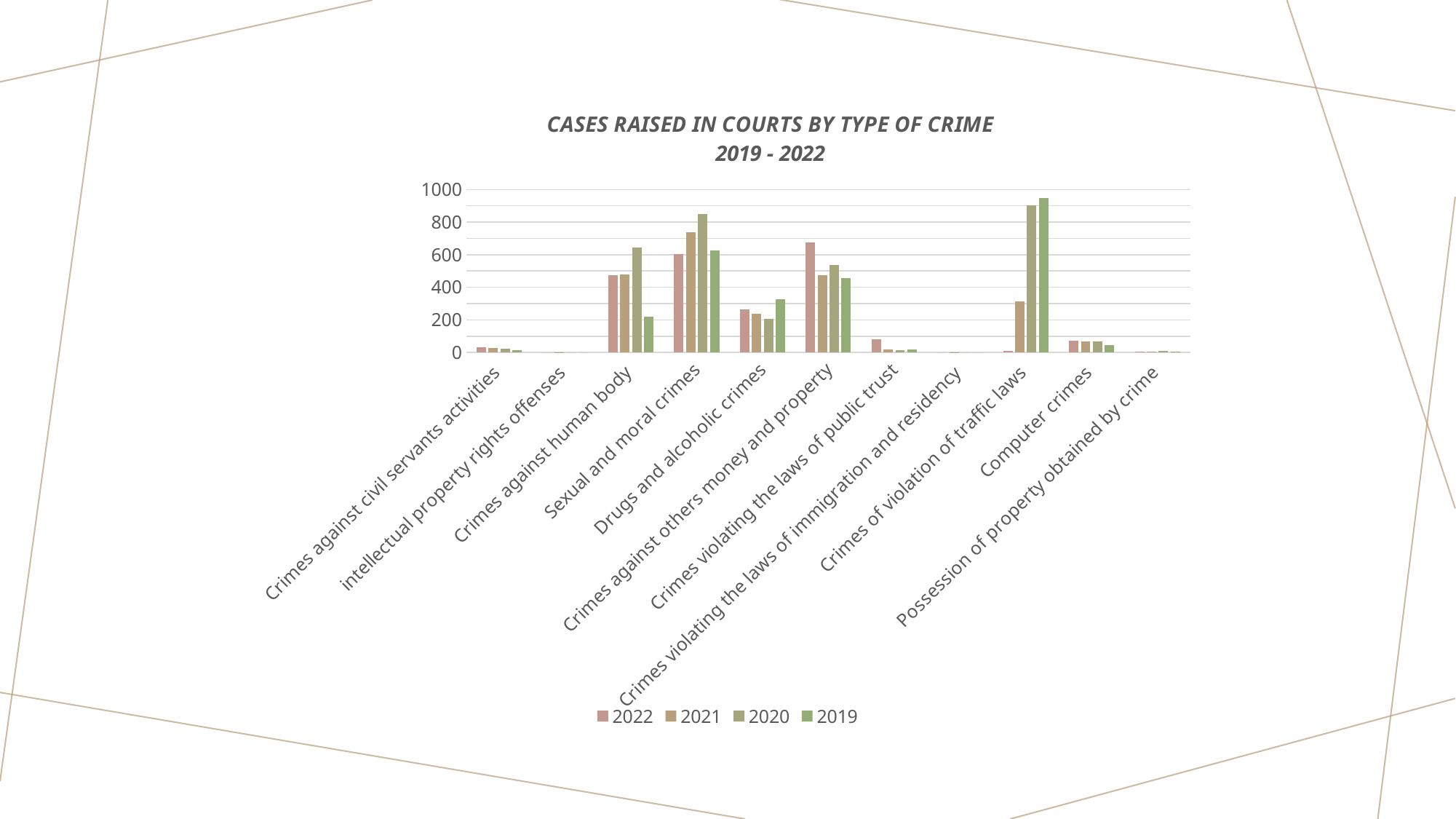
How many series does the legend list? 4 What kind of chart is shown on the slide? bar chart Is the 2021 value for Crimes of violation of traffic laws greater or less than 400? less Is the 2019 value for Crimes against human body greater or less than 400? less Is the 2022 value for Crimes against others money and property greater or less than 600? greater How many crime categories are shown on the x axis? 11 Which year has the highest value for Crimes against others money and property? 2022 For Sexual and moral crimes, which is larger: the 2021 value or the 2022 value? 2021 Which year has the lowest value for Crimes of violation of traffic laws? 2022 What is the title of the chart? CASES RAISED IN COURTS BY TYPE OF CRIME 2019 - 2022 Which year has the highest value for Sexual and moral crimes? 2020